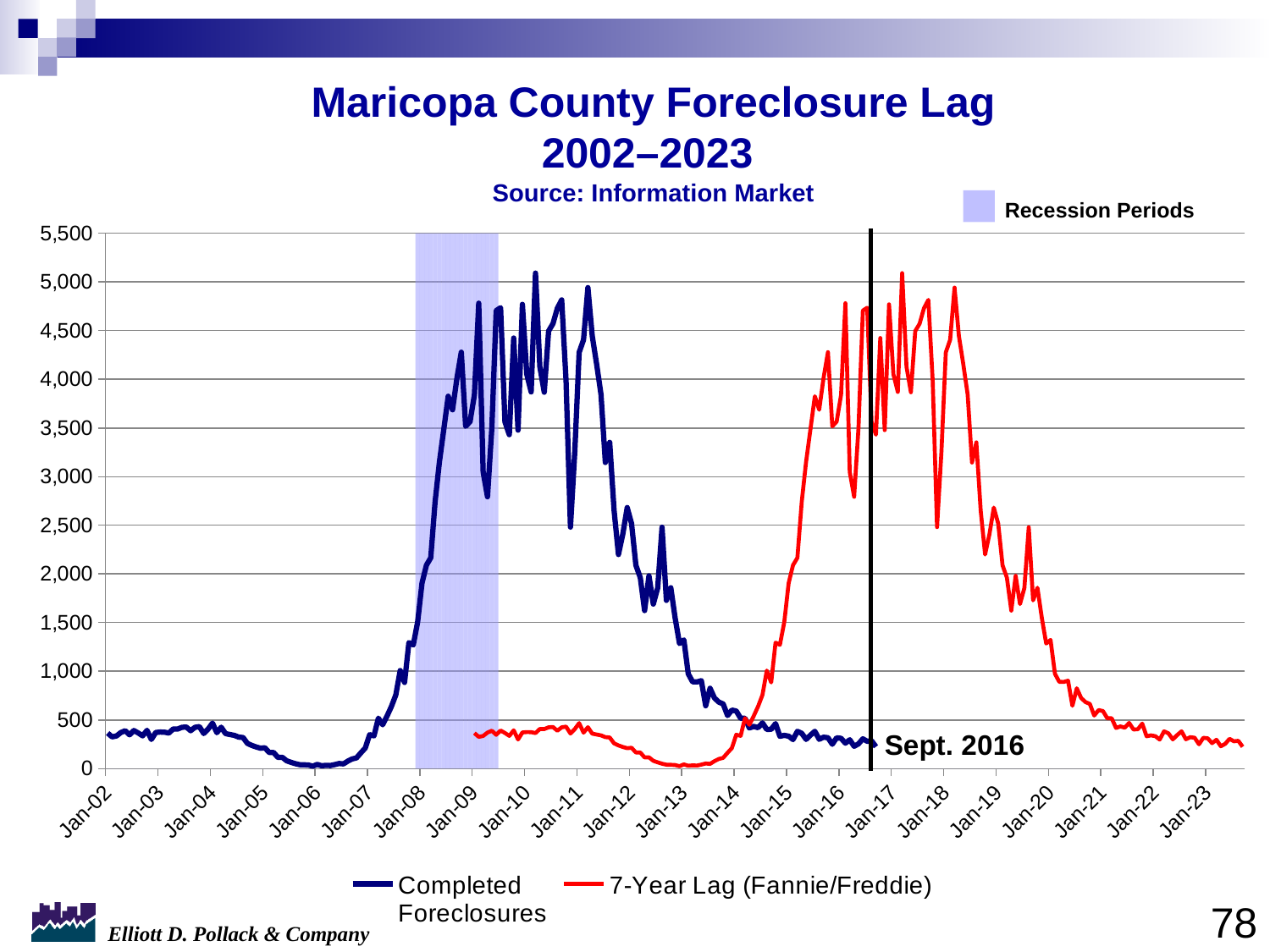
Which series is drawn in red? 7-Year Lag (Fannie/Freddie) Is the value for Completed Foreclosures at Jan-06 greater or less than 500? less How many series does the legend list? 2 Is the value for Completed Foreclosures at Jan-02 greater or less than 500? less What kind of chart is shown on the slide? line chart Which is larger: Completed Foreclosures at Jan-10 or Completed Foreclosures at Jan-02? Jan-10 What is the title of the chart? Maricopa County Foreclosure Lag 2002–2023 Does the 7-Year Lag (Fannie/Freddie) line rise or fall between Jan-14 and Jan-16? rise Is the peak value of Completed Foreclosures around Jan-10 greater or less than 5,000? greater Does the Completed Foreclosures line rise or fall between Jan-11 and Jan-14? fall How many year labels are shown on the x axis? 22